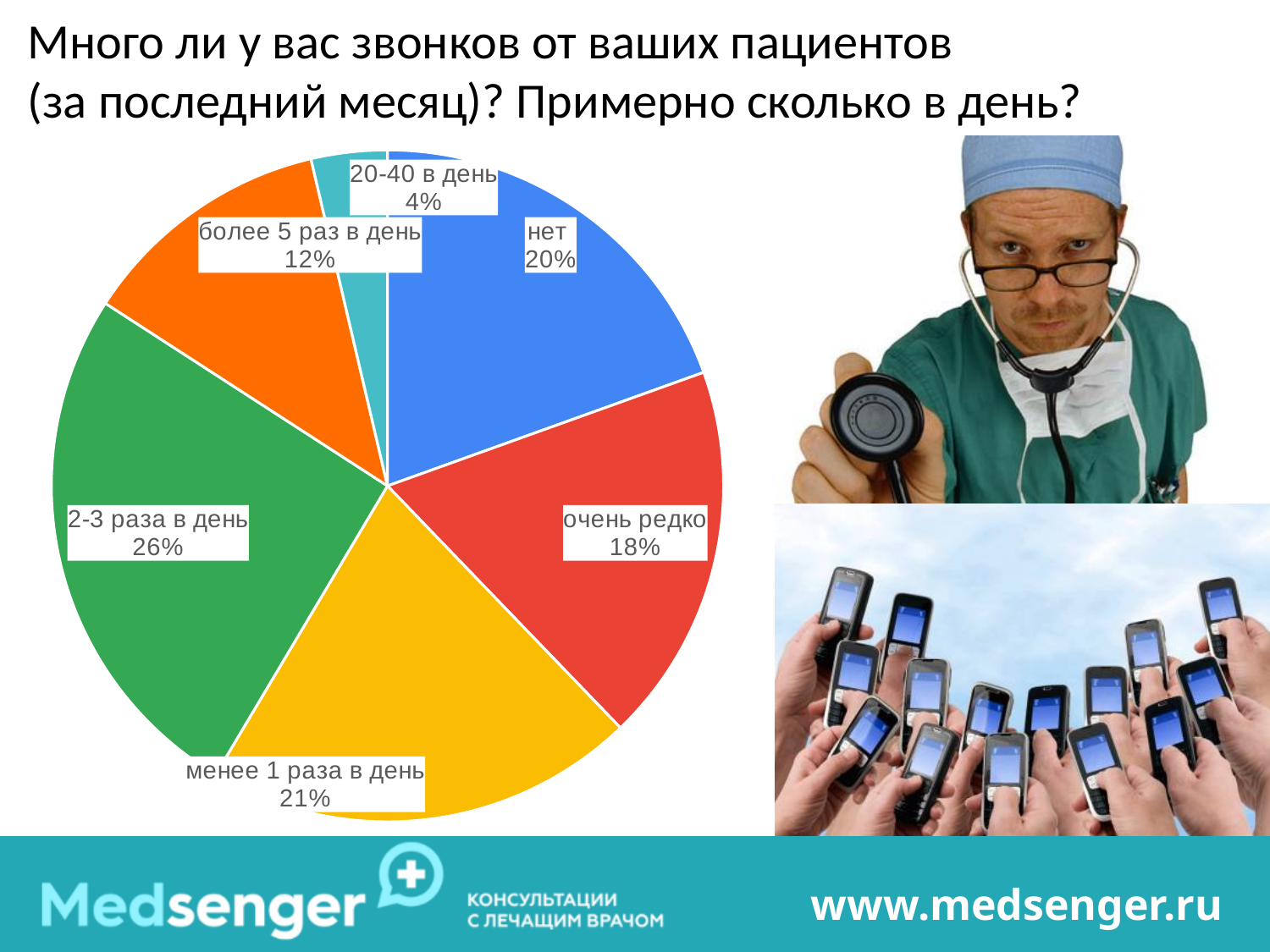
What share of respondents answered "более 5 раз в день"? 12% How many slices does the pie chart have? 6 Which is larger: the share for "нет" or the share for "очень редко"? нет What is the difference in percentage points between "2-3 раза в день" and "более 5 раз в день"? 14 Which answer has the smallest share of the pie? 20-40 в день What share of respondents answered "2-3 раза в день"? 26% What share of respondents answered "20-40 в день"? 4% Which answer has the largest share of the pie? 2-3 раза в день What type of chart is shown on the slide? pie chart What share of respondents answered "нет"? 20% What share of respondents answered "очень редко"? 18% What share of respondents answered "менее 1 раза в день"? 21%